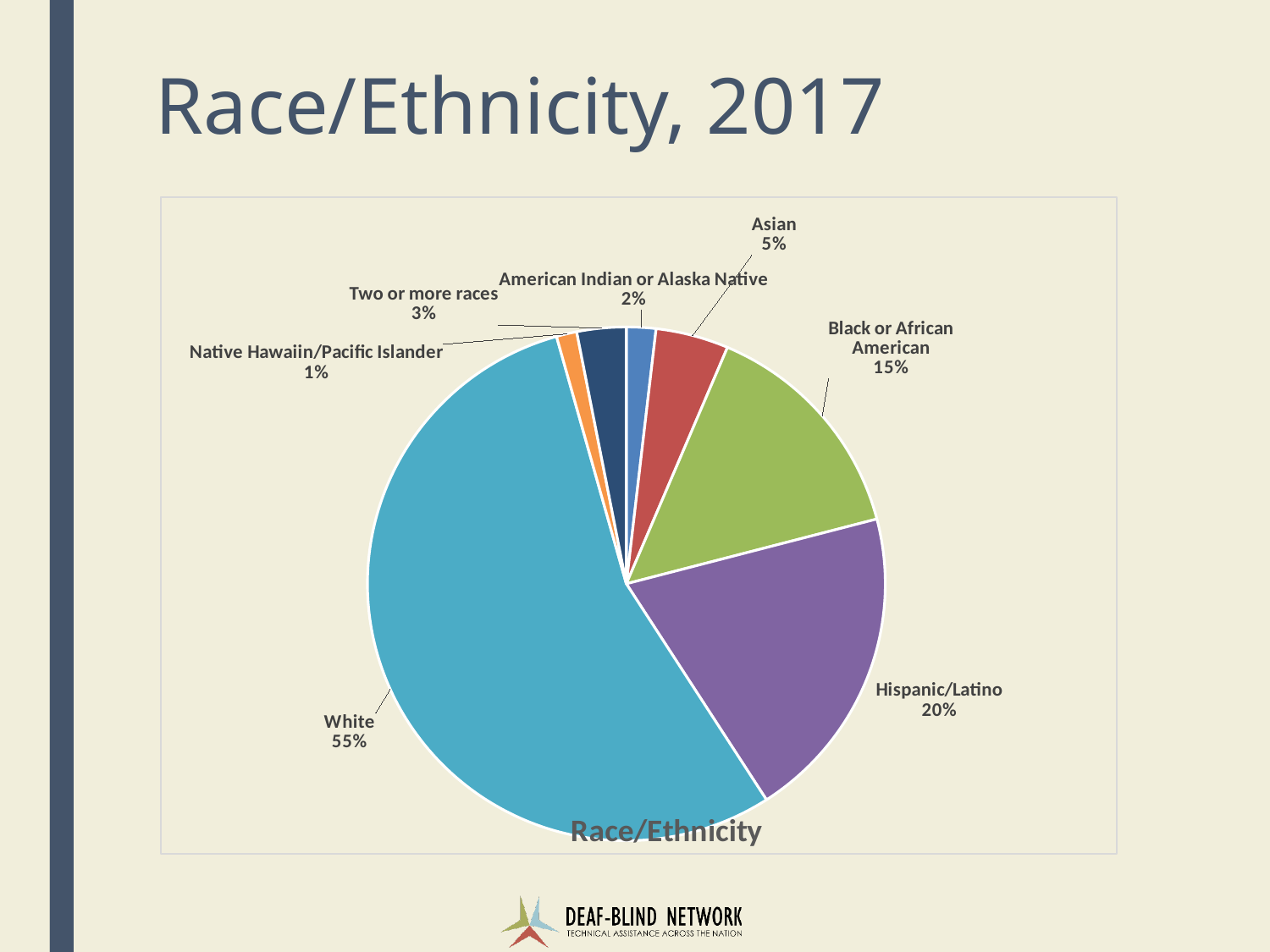
What percentage of the pie is Hispanic/Latino? 20% What kind of chart is shown on the slide? pie chart Which category has the smallest share of the pie? Native Hawaiin/Pacific Islander What is the difference in percentage points between Hispanic/Latino and Black or African American? 5 What percentage of the pie is Asian? 5% What is the title of the chart? Race/Ethnicity How many slices does the pie chart have? 7 Which is larger, the share for Two or more races or the share for American Indian or Alaska Native? Two or more races Which category has the largest share of the pie? White What percentage of the pie is Native Hawaiin/Pacific Islander? 1% What percentage of the pie is Black or African American? 15% What percentage of the pie is White? 55%